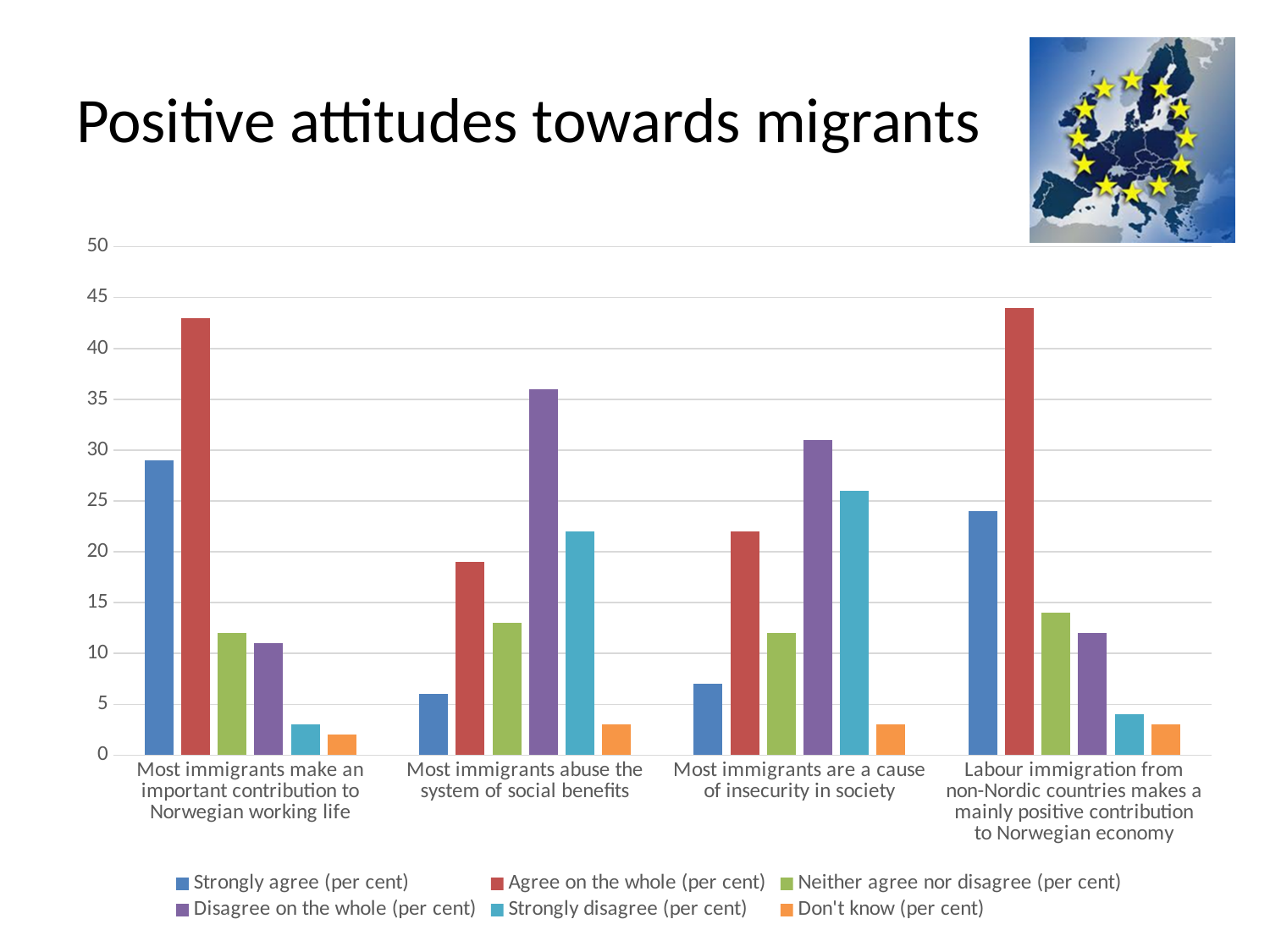
For 'Most immigrants abuse the system of social benefits', which response series has the highest bar? Disagree on the whole (per cent) Is the 'Strongly disagree' value for 'Most immigrants are a cause of insecurity in society' greater or less than 20? greater Is the 'Strongly agree' value for 'Most immigrants make an important contribution to Norwegian working life' greater or less than 25? greater For 'Most immigrants make an important contribution to Norwegian working life', which response series has the highest bar? Agree on the whole (per cent) What kind of chart is shown on the slide? bar chart What colour represents the 'Don't know (per cent)' series? orange For 'Most immigrants make an important contribution to Norwegian working life', which response series has the lowest bar? Don't know (per cent) Is the 'Agree on the whole' value for 'Labour immigration from non-Nordic countries makes a mainly positive contribution to Norwegian economy' greater or less than 40? greater How many series does the legend list? 6 How many categories (statements) are shown on the x axis? 4 Which has the larger 'Strongly agree' value: 'Most immigrants make an important contribution to Norwegian working life' or 'Labour immigration from non-Nordic countries makes a mainly positive contribution to Norwegian economy'? Most immigrants make an important contribution to Norwegian working life